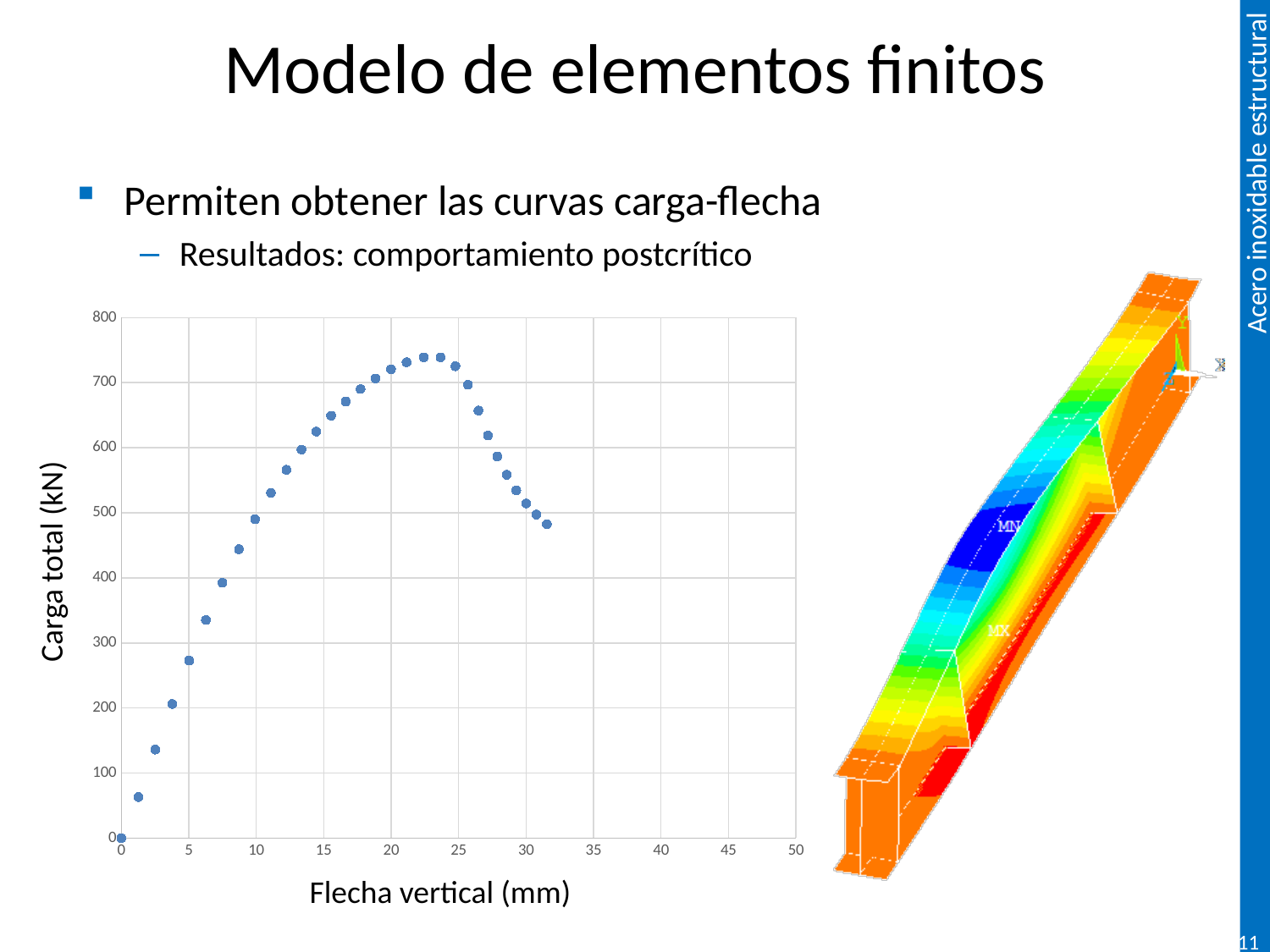
What kind of chart is shown on the slide? scatter chart Is the load (Carga total) at a vertical deflection of 20 mm greater or less than 700 kN? greater How does the load (Carga total) change as the vertical deflection increases beyond about 25 mm? it falls What is the label of the horizontal axis of the chart? Flecha vertical (mm) How does the load (Carga total) change as the vertical deflection increases from 0 to about 22 mm? it rises Is the load (Carga total) at a vertical deflection of 5 mm greater or less than 300 kN? less Is the load (Carga total) at a vertical deflection of 5 mm greater or less than 200 kN? greater What is the label of the vertical axis of the chart? Carga total (kN)